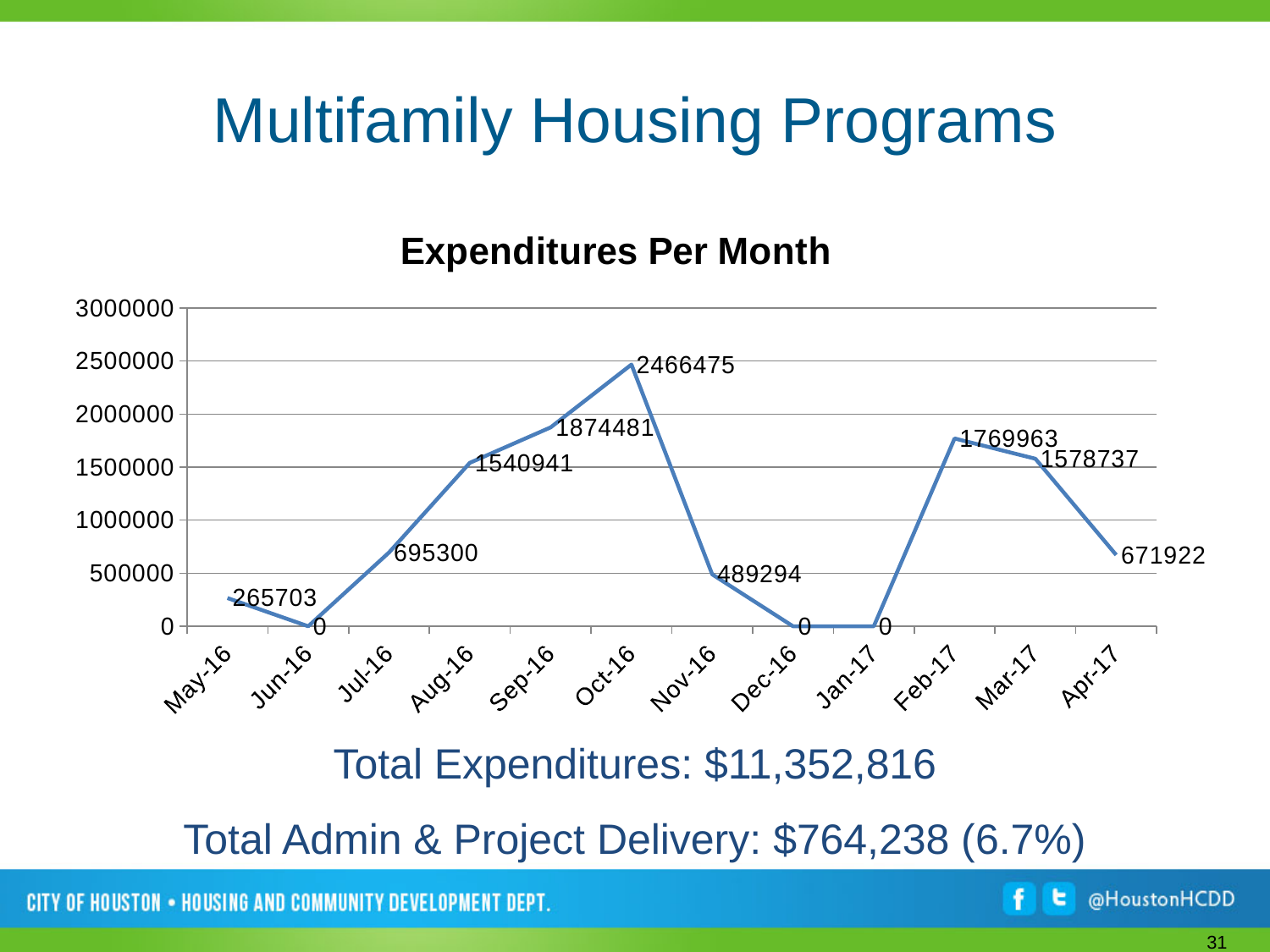
What is the expenditure value for Oct-16? 2466475 What is the difference between the Feb-17 and Mar-17 expenditures? 191226 What is the title of the chart? Expenditures Per Month What is the difference between the Oct-16 and Sep-16 expenditures? 591994 How many months are plotted on the x axis? 12 What is the expenditure value for Aug-16? 1540941 Is the value for Nov-16 greater or less than 500000? less What is the expenditure value for Apr-17? 671922 What kind of chart is shown? line chart Which is larger, the expenditure for Feb-17 or for Sep-16? Sep-16 How many months show an expenditure of 0? 3 Which month has the highest expenditure? Oct-16